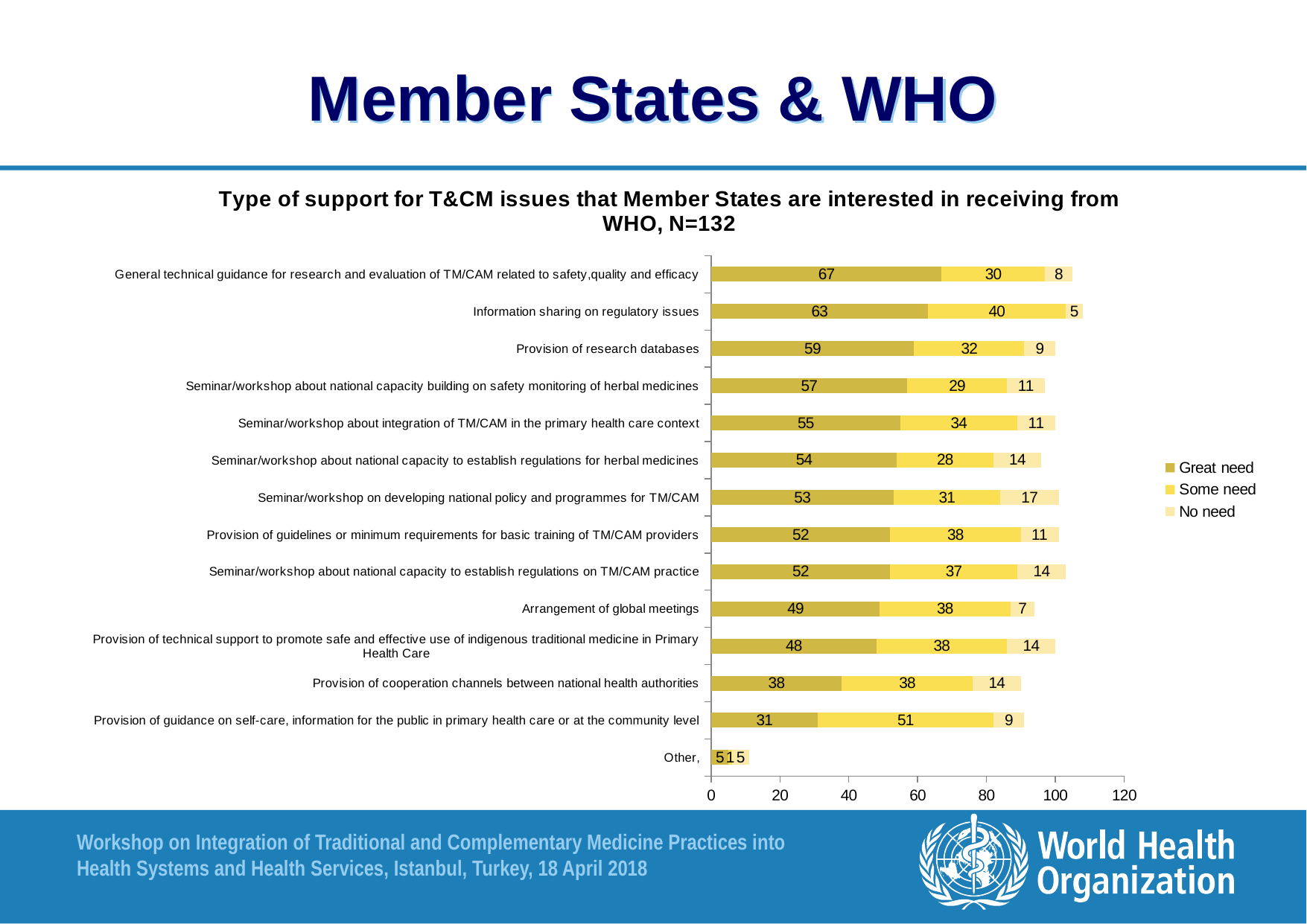
What is the 'Great need' value for 'Information sharing on regulatory issues'? 63 What is the difference between the 'Great need' values for 'General technical guidance for research and evaluation of TM/CAM related to safety,quality and efficacy' and 'Information sharing on regulatory issues'? 4 How many categories are shown on the chart? 14 What kind of chart is shown on the slide? Stacked bar chart What is the 'No need' value for 'Seminar/workshop on developing national policy and programmes for TM/CAM'? 17 Which category has the lowest 'Some need' value? Other What is the total of the stacked bar for 'Arrangement of global meetings'? 94 What is the 'Some need' value for 'Provision of guidance on self-care, information for the public in primary health care or at the community level'? 51 Which has the larger 'Some need' value: 'Information sharing on regulatory issues' or 'Provision of research databases'? Information sharing on regulatory issues Which category has the highest 'Great need' value? General technical guidance for research and evaluation of TM/CAM related to safety,quality and efficacy What is the total of the stacked bar for 'Information sharing on regulatory issues'? 108 How many series does the legend list? 3